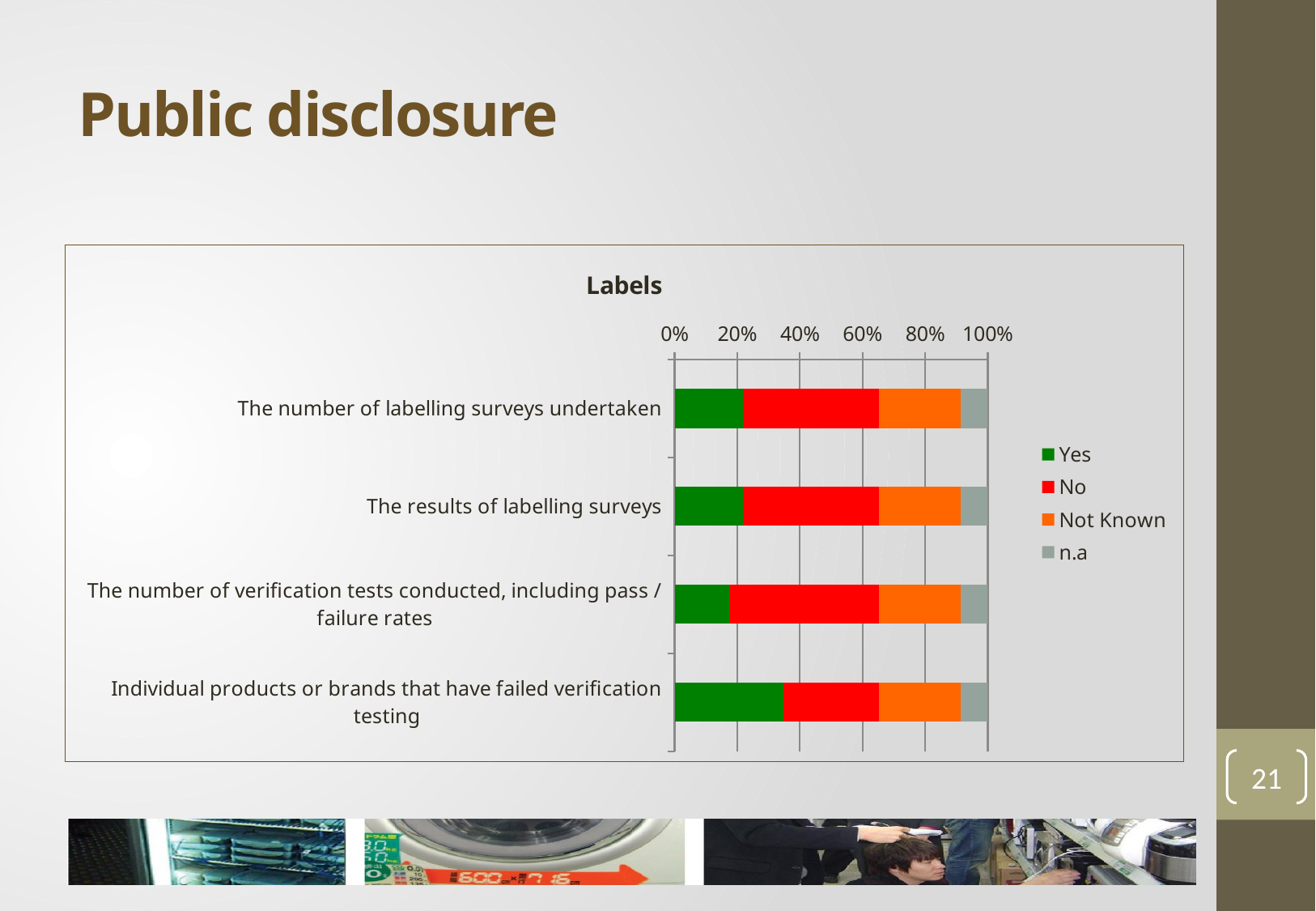
Which legend entry is shown in green? Yes Which has a larger 'Yes' share: 'Individual products or brands that have failed verification testing' or 'The number of verification tests conducted, including pass / failure rates'? Individual products or brands that have failed verification testing How many categories are plotted on the chart? 4 Is the 'Yes' share for 'The number of labelling surveys undertaken' greater or less than 40%? less Which category has the largest 'Yes' share? Individual products or brands that have failed verification testing What kind of chart is shown on the slide? Stacked bar chart Is the 'Yes' share for 'Individual products or brands that have failed verification testing' greater or less than 20%? greater Which has a larger 'No' share: 'The number of verification tests conducted, including pass / failure rates' or 'Individual products or brands that have failed verification testing'? The number of verification tests conducted, including pass / failure rates Which category has the smallest 'Yes' share? The number of verification tests conducted, including pass / failure rates How many series does the legend list? 4 Is the 'Yes' share for 'The number of verification tests conducted, including pass / failure rates' greater or less than 20%? less What is the title of the chart? Labels